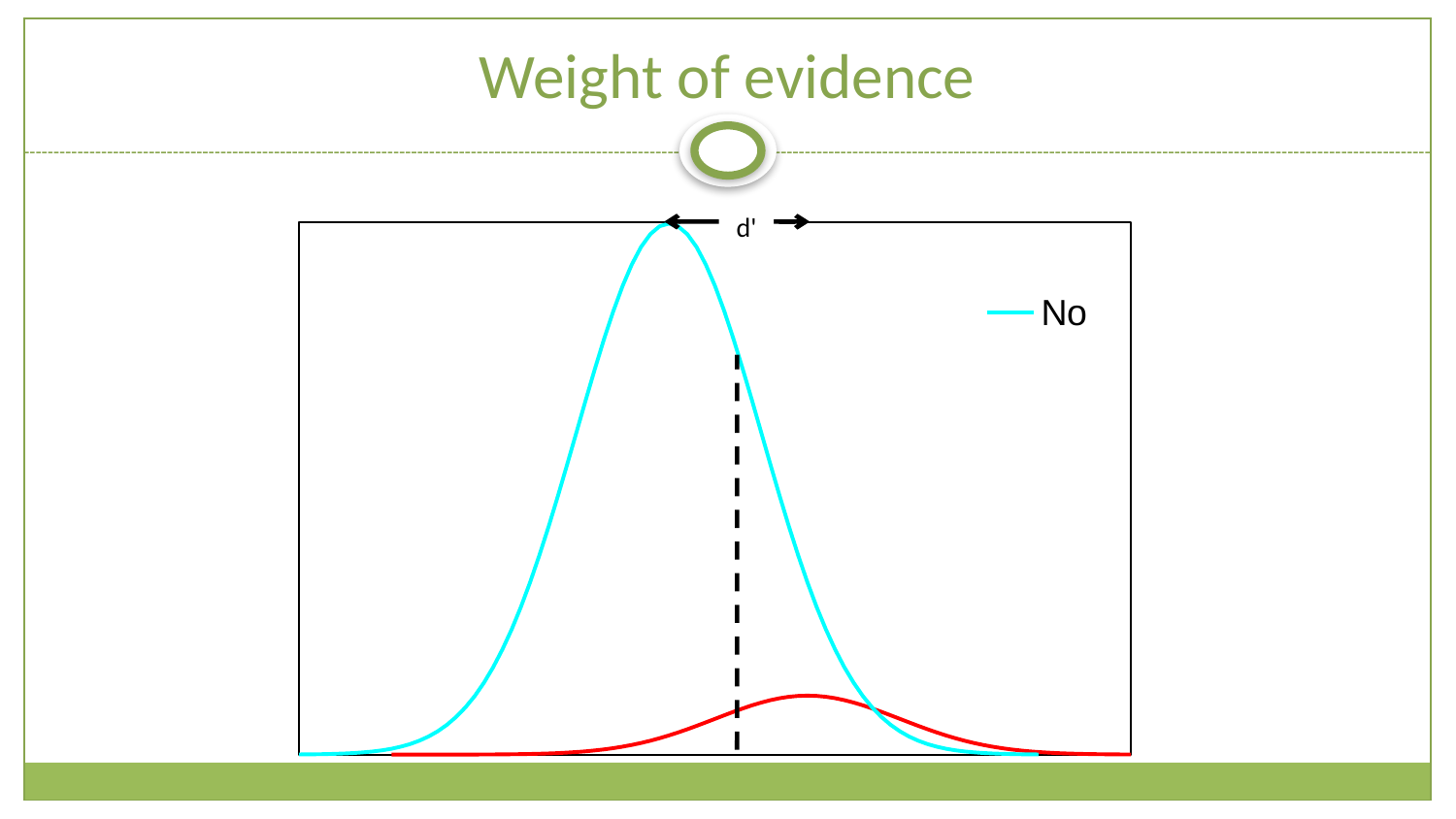
What is the name of the series listed in the chart's legend? No What kind of chart is shown on the slide? line chart Does the cyan curve rise or fall to the right of its peak? fall Which curve reaches a higher peak, the cyan curve or the red curve? the cyan curve How many series does the chart's legend list? 1 Which curve has the lowest peak on the chart? the red curve How many curves are plotted on the chart? 2 What colour is the line for the series labelled "No" in the legend? cyan